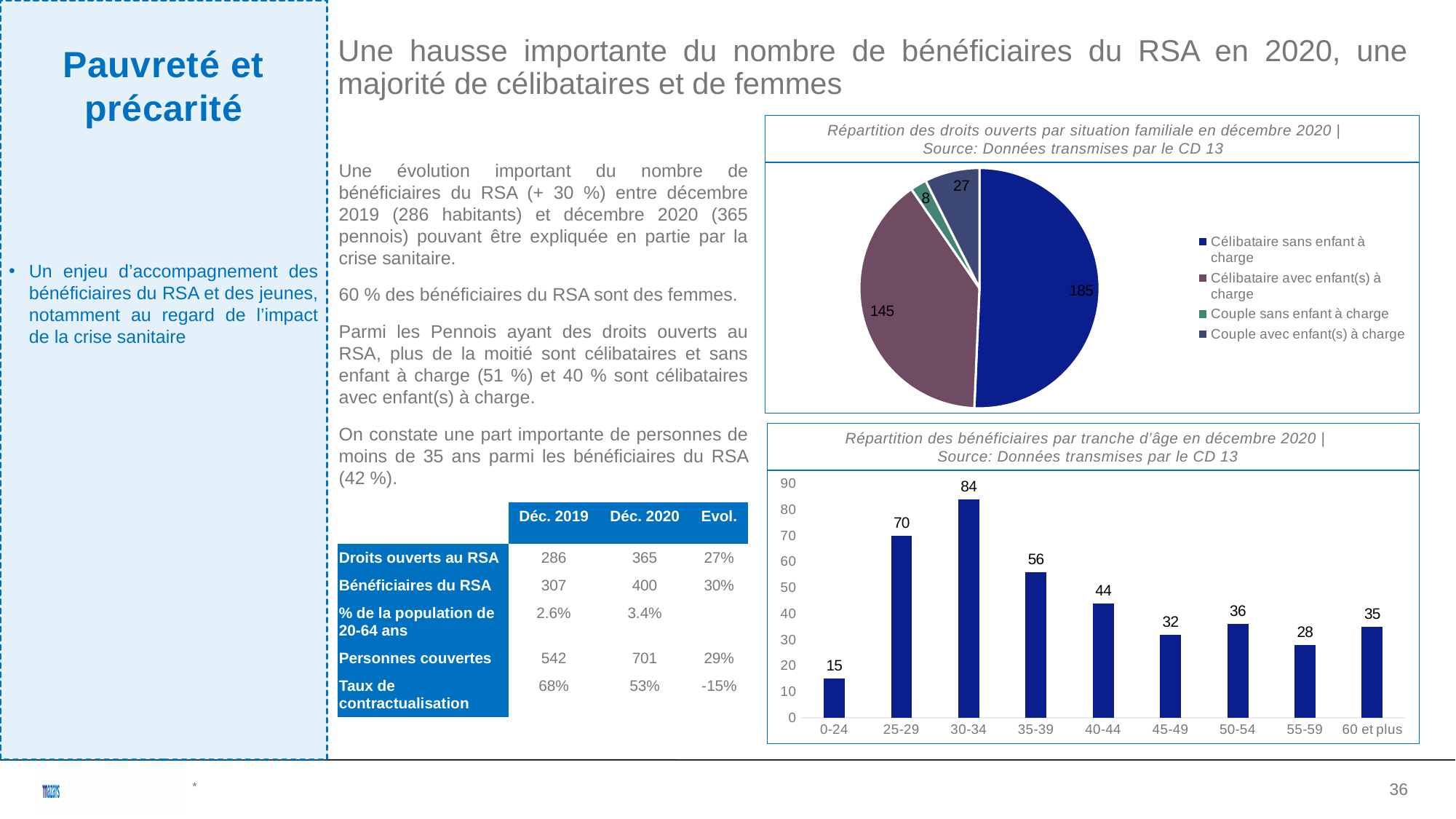
In the bar chart 'Répartition des bénéficiaires par tranche d'âge en décembre 2020', which age group has the lowest value? 0-24 In the bar chart 'Répartition des bénéficiaires par tranche d'âge en décembre 2020', what is the value for the 30-34 age group? 84 In the bar chart 'Répartition des bénéficiaires par tranche d'âge en décembre 2020', what is the difference between the values for 25-29 and 35-39? 14 In the pie chart 'Répartition des droits ouverts par situation familiale en décembre 2020', which category has the largest slice? Célibataire sans enfant à charge In the bar chart 'Répartition des bénéficiaires par tranche d'âge en décembre 2020', do the values rise or fall from the 30-34 group to the 45-49 group? Fall How many categories does the legend of the pie chart 'Répartition des droits ouverts par situation familiale en décembre 2020' list? 4 In the bar chart 'Répartition des bénéficiaires par tranche d'âge en décembre 2020', which is larger: the value for 50-54 or the value for 55-59? 50-54 In the pie chart 'Répartition des droits ouverts par situation familiale en décembre 2020', what is the value for 'Couple sans enfant à charge'? 8 What kind of chart is 'Répartition des bénéficiaires par tranche d'âge en décembre 2020'? Bar chart In the pie chart 'Répartition des droits ouverts par situation familiale en décembre 2020', what is the value for 'Célibataire sans enfant à charge'? 185 In the bar chart 'Répartition des bénéficiaires par tranche d'âge en décembre 2020', how many age groups are shown on the x axis? 9 In the pie chart 'Répartition des droits ouverts par situation familiale en décembre 2020', what is the difference between 'Célibataire sans enfant à charge' and 'Célibataire avec enfant(s) à charge'? 40